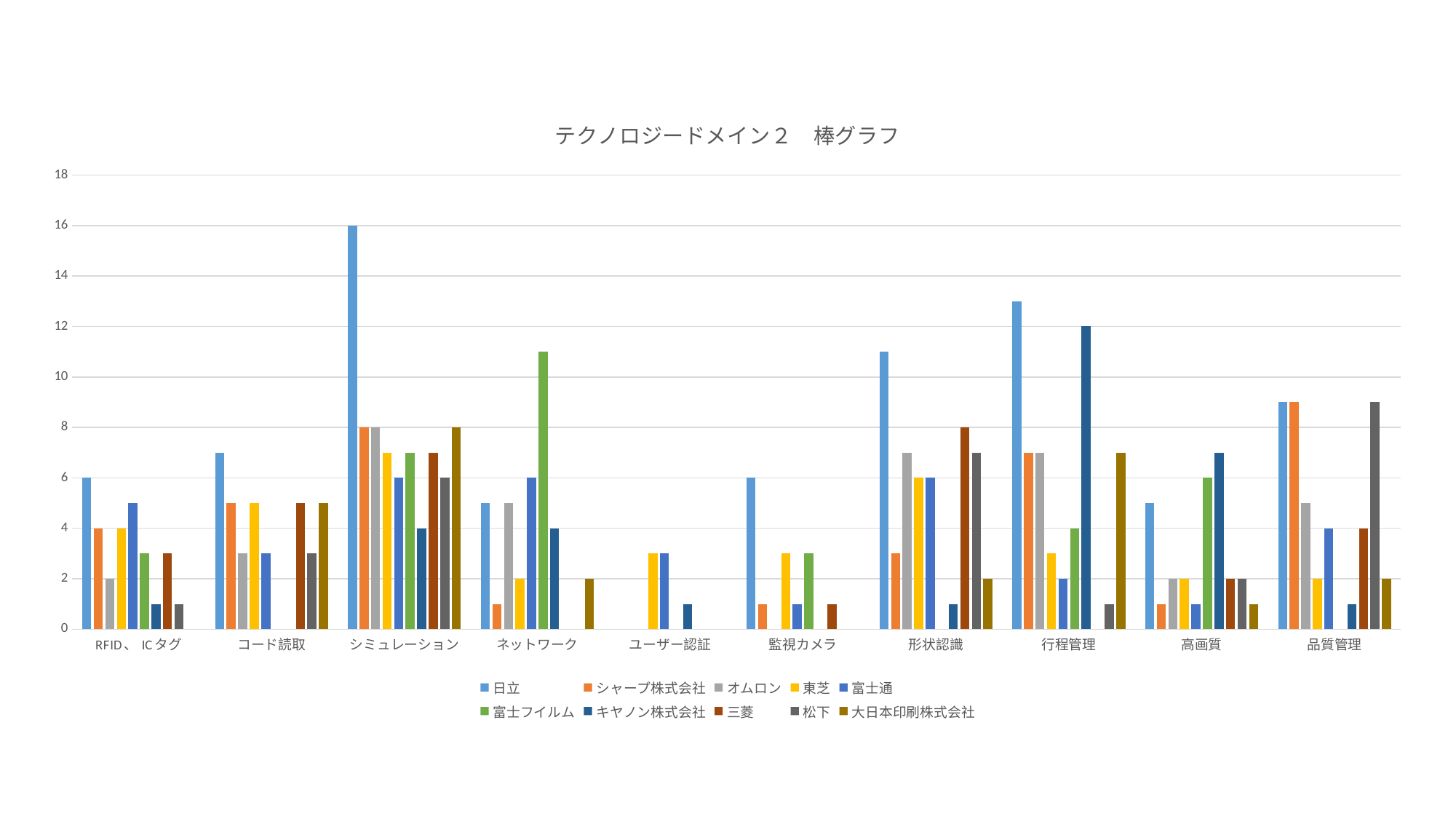
What is the value for キヤノン株式会社 in the 行程管理 category? 12 What is the title of the chart? テクノロジードメイン２ 棒グラフ Is the value for 日立 in the 行程管理 category greater or less than 12? greater What is the difference between the value for 日立 in シミュレーション and the value for 日立 in RFID、ICタグ? 10 How many series does the legend list? 10 What kind of chart is shown on the slide? bar chart What is the value for 三菱 in the 形状認識 category? 8 How many categories are shown on the x axis? 10 Is the value for 富士フイルム in the ネットワーク category greater or less than 10? greater What is the value for 日立 in the シミュレーション category? 16 Which is larger: the value for 日立 in シミュレーション or the value for 日立 in 行程管理? 日立 in シミュレーション In which category does 日立 have its highest value? シミュレーション